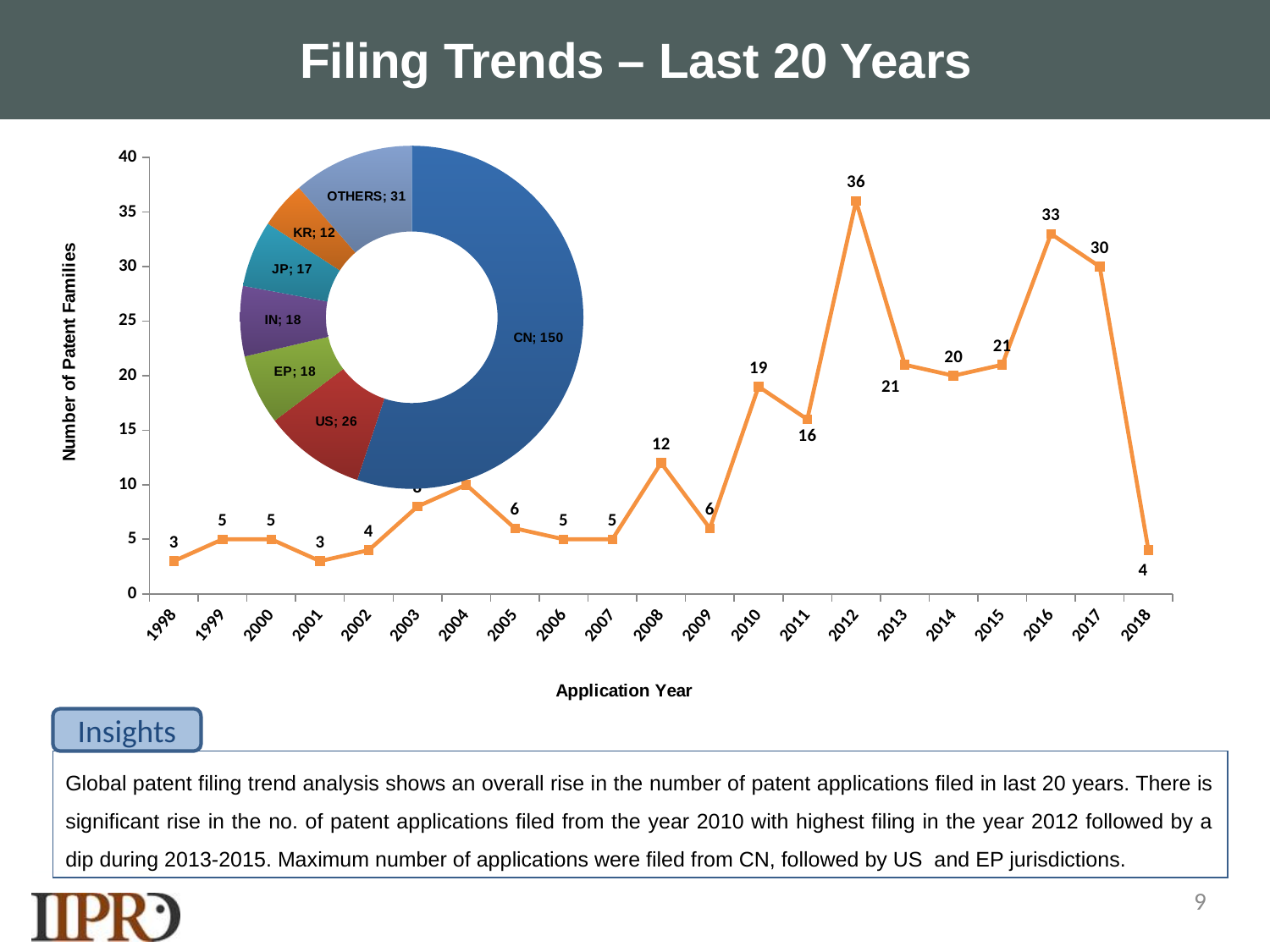
In the line chart, which application year has the highest number of patent families? 2012 In the donut chart, how much larger is the US value than the EP value? 8 In the line chart, do the values rise or fall from 2016 to 2018? fall In the line chart, how many patent families were filed in 2012? 36 What kind of chart shows the number of patent families by application year? line chart In the donut chart, what is the value shown for CN? 150 How many application years are plotted on the x axis of the line chart? 21 In the line chart, what is the difference between the values for 2016 and 2017? 3 In the line chart, is the value for 2004 greater or less than 5? greater In the donut chart, what is the value shown for US? 26 In the line chart, which year has the larger value, 2010 or 2011? 2010 In the donut chart, which jurisdiction has the smallest number of patent families? KR